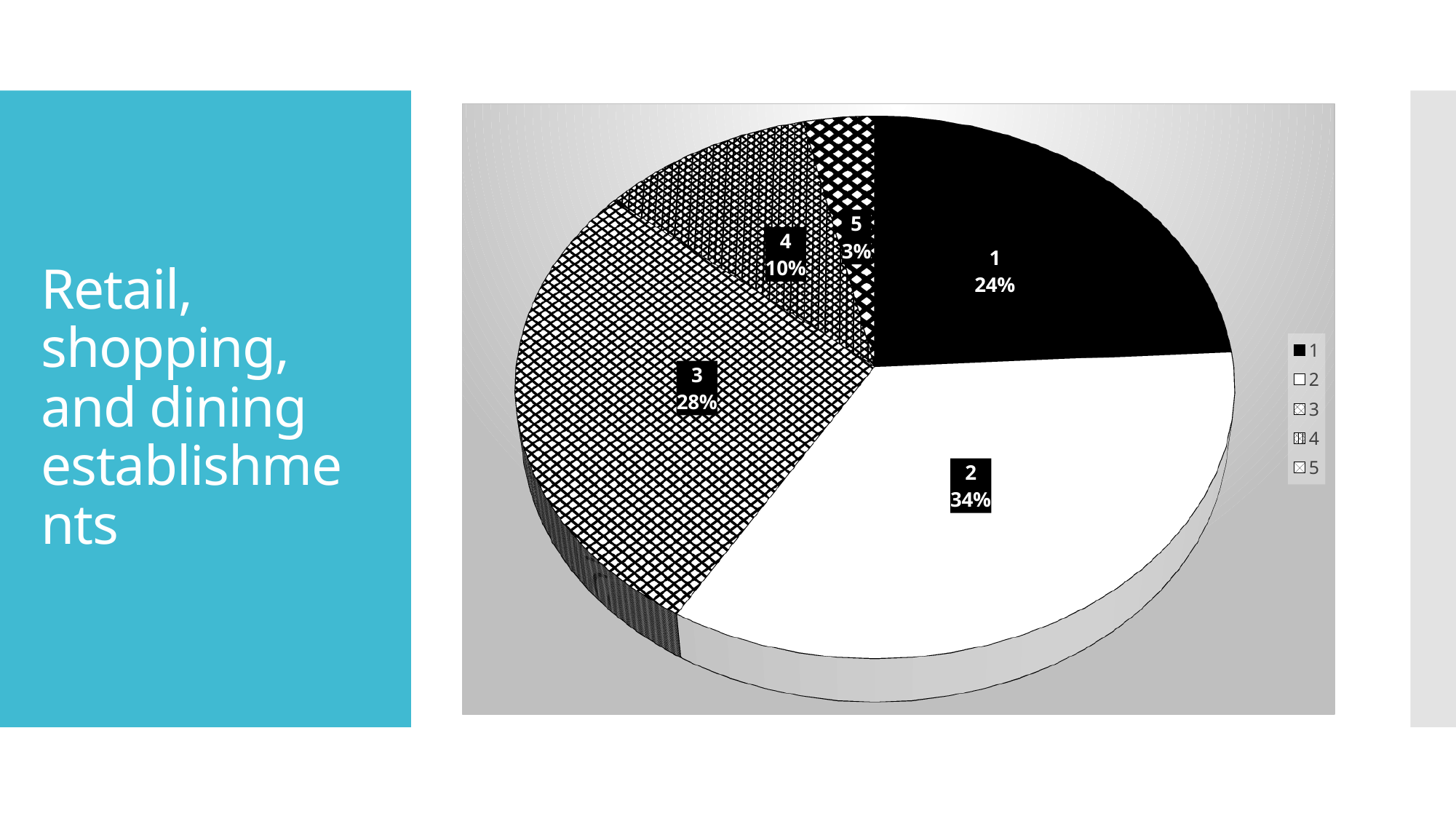
What percentage share does category 1 have in the pie chart? 24% How many slices does the pie chart have? 5 Which category has the smallest slice of the pie chart? 5 What percentage share does category 4 have in the pie chart? 10% Which is larger, the share for category 3 or the share for category 4? 3 What is the difference in percentage points between category 2 and category 1? 10 What percentage share does category 5 have in the pie chart? 3% How many entries does the legend list? 5 What percentage share does category 3 have in the pie chart? 28% What kind of chart is shown on the slide? pie chart What percentage share does category 2 have in the pie chart? 34% Which category has the largest slice of the pie chart? 2